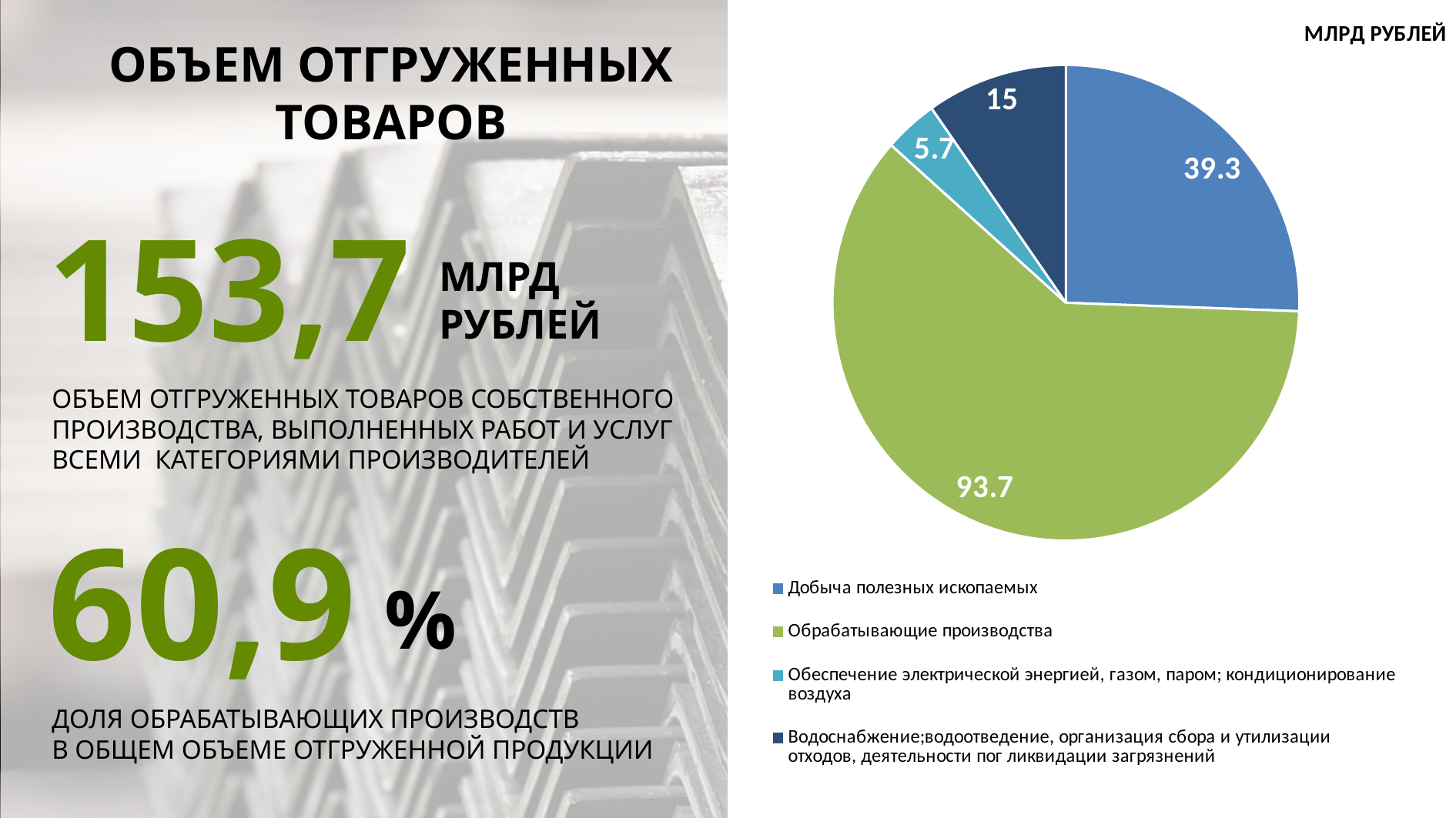
Which category has the largest slice in the pie chart? Обрабатывающие производства Which is larger: the value for Добыча полезных ископаемых or the value for Водоснабжение; водоотведение? Добыча полезных ископаемых What is the total of all slices in the pie chart? 153.7 What is the value for Обеспечение электрической энергией, газом, паром; кондиционирование воздуха in the pie chart? 5.7 What kind of chart is shown on the slide? pie chart Which category has the smallest slice in the pie chart? Обеспечение электрической энергией, газом, паром; кондиционирование воздуха What is the value for Обрабатывающие производства in the pie chart? 93.7 How many categories does the pie chart show? 4 In what units are the pie chart values given? МЛРД РУБЛЕЙ What is the difference between the values for Обрабатывающие производства and Добыча полезных ископаемых? 54.4 What is the value for Добыча полезных ископаемых in the pie chart? 39.3 What is the value for Водоснабжение; водоотведение, организация сбора и утилизации отходов, деятельности по ликвидации загрязнений in the pie chart? 15